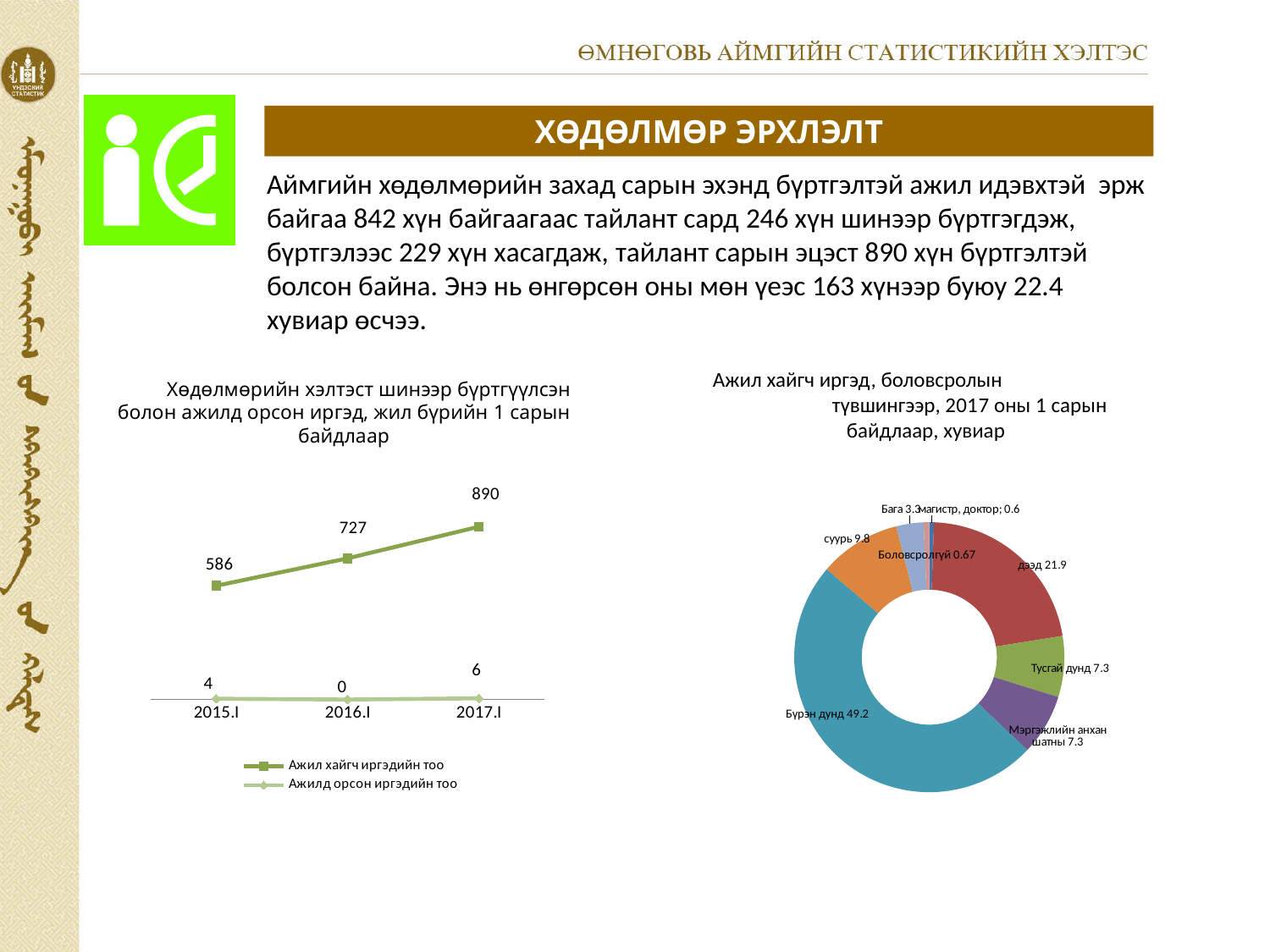
How many series does the legend of the left line chart list? 2 In the left line chart, does the Ажил хайгч иргэдийн тоо series rise or fall from 2015.I to 2017.I? rise In the left line chart, which period has the highest value for Ажил хайгч иргэдийн тоо? 2017.I What type of chart is the left chart on the slide? line chart In the left line chart, what is the value of Ажил хайгч иргэдийн тоо for 2017.I? 890 In the right doughnut chart, what is the share for Бүрэн дунд? 49.2 In the left line chart, what is the value of Ажилд орсон иргэдийн тоо for 2016.I? 0 In the right doughnut chart, what is the share for дээд? 21.9 In the left line chart, what is the difference between the Ажил хайгч иргэдийн тоо values for 2017.I and 2015.I? 304 In the right doughnut chart, which is larger: суурь or Тусгай дунд? суурь How many periods are shown on the x axis of the left line chart? 3 In the right doughnut chart, which category has the smallest share? магистр, доктор